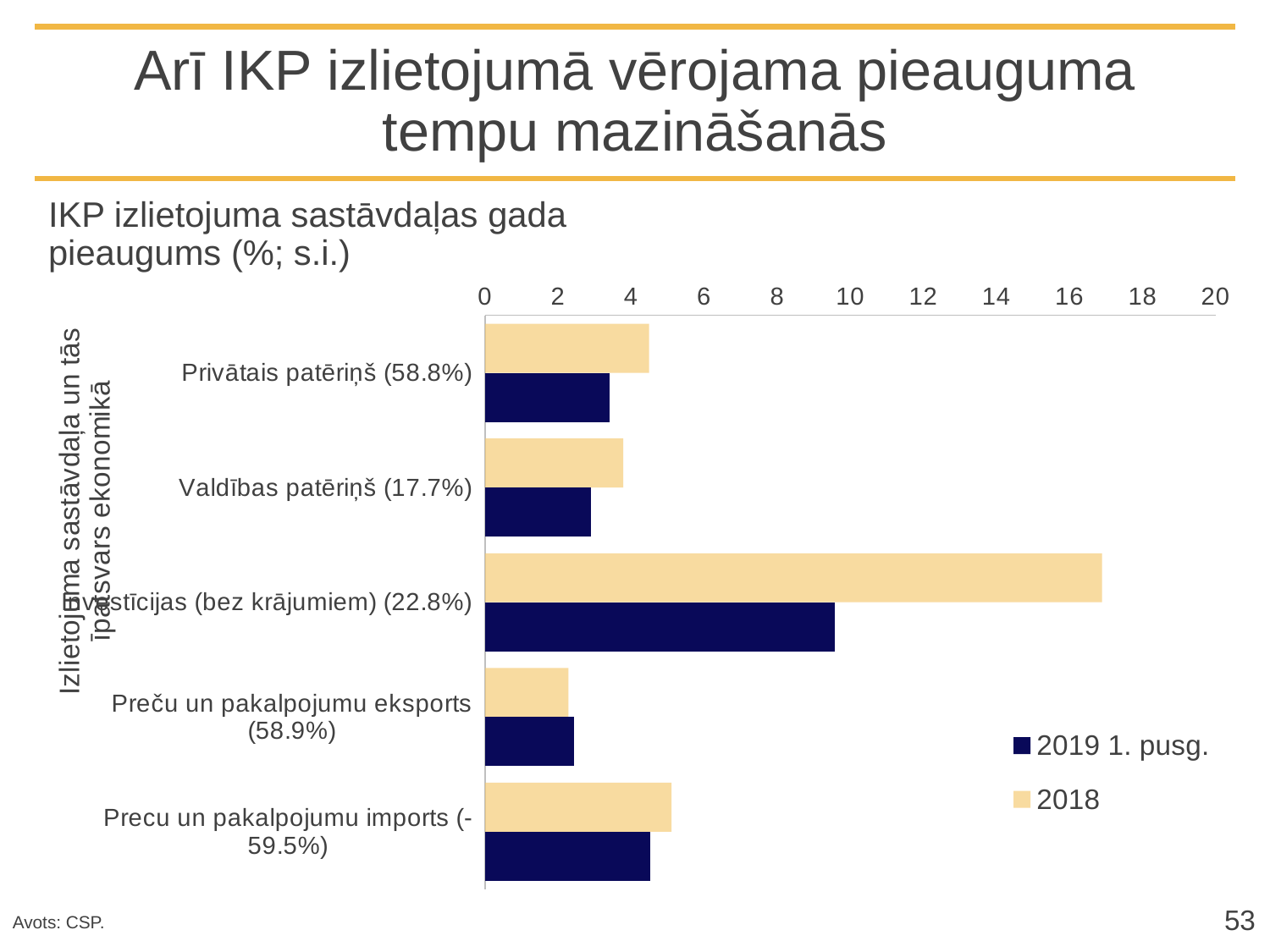
Which category has the lowest value for 2018? Preču un pakalpojumu eksports (58.9%) Which category has the highest value for 2018? Investīcijas (bez krājumiem) (22.8%) What kind of chart is shown on the slide? bar chart For Investīcijas (bez krājumiem), which series has the larger value, 2018 or 2019 1. pusg.? 2018 Which series is shown in dark navy bars? 2019 1. pusg. Is the 2019 1. pusg. value for Investīcijas (bez krājumiem) greater or less than 8? greater How many series does the legend list? 2 For Privātais patēriņš, which series has the larger value, 2018 or 2019 1. pusg.? 2018 Is the 2018 value for Investīcijas (bez krājumiem) greater or less than 16? greater Which category has the highest value for 2019 1. pusg.? Investīcijas (bez krājumiem) (22.8%) Is the 2018 value for Privātais patēriņš greater or less than 4? greater How many categories are plotted on the chart? 5